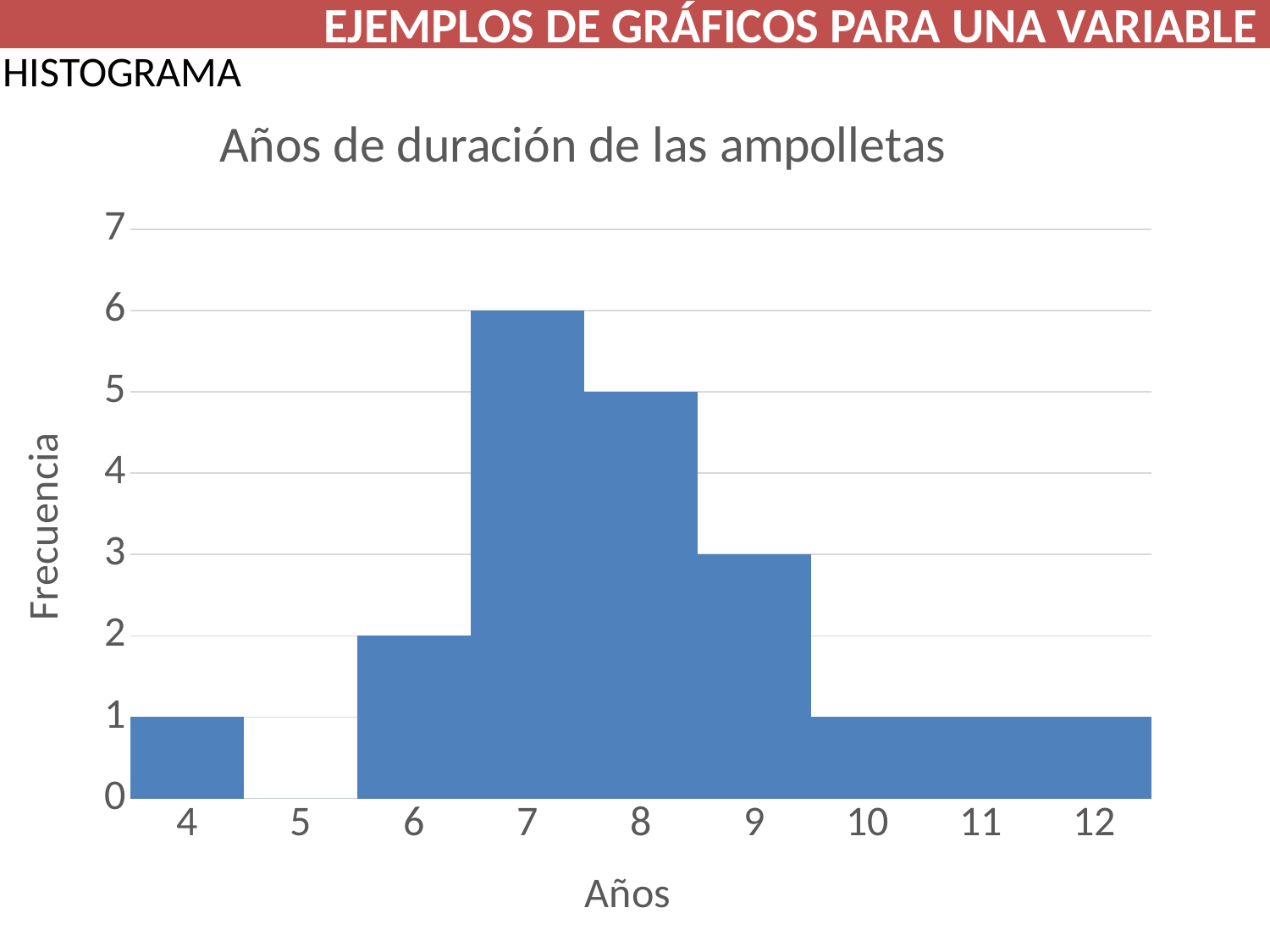
What is the frequency for 5 years? 0 What kind of chart is shown on the slide? Histogram (bar chart) What is the title of the chart? Años de duración de las ampolletas What is the difference between the frequency for 7 years and the frequency for 9 years? 3 What is the frequency for 8 years? 5 What is the frequency for 7 years in the histogram? 6 Which number of years has the lowest frequency? 5 What is the frequency for 6 years? 2 Do the frequencies rise or fall from 9 years to 10 years? Fall Which has a higher frequency, 8 years or 9 years? 8 years Which number of years has the highest frequency? 7 How many year categories are shown on the x axis? 9